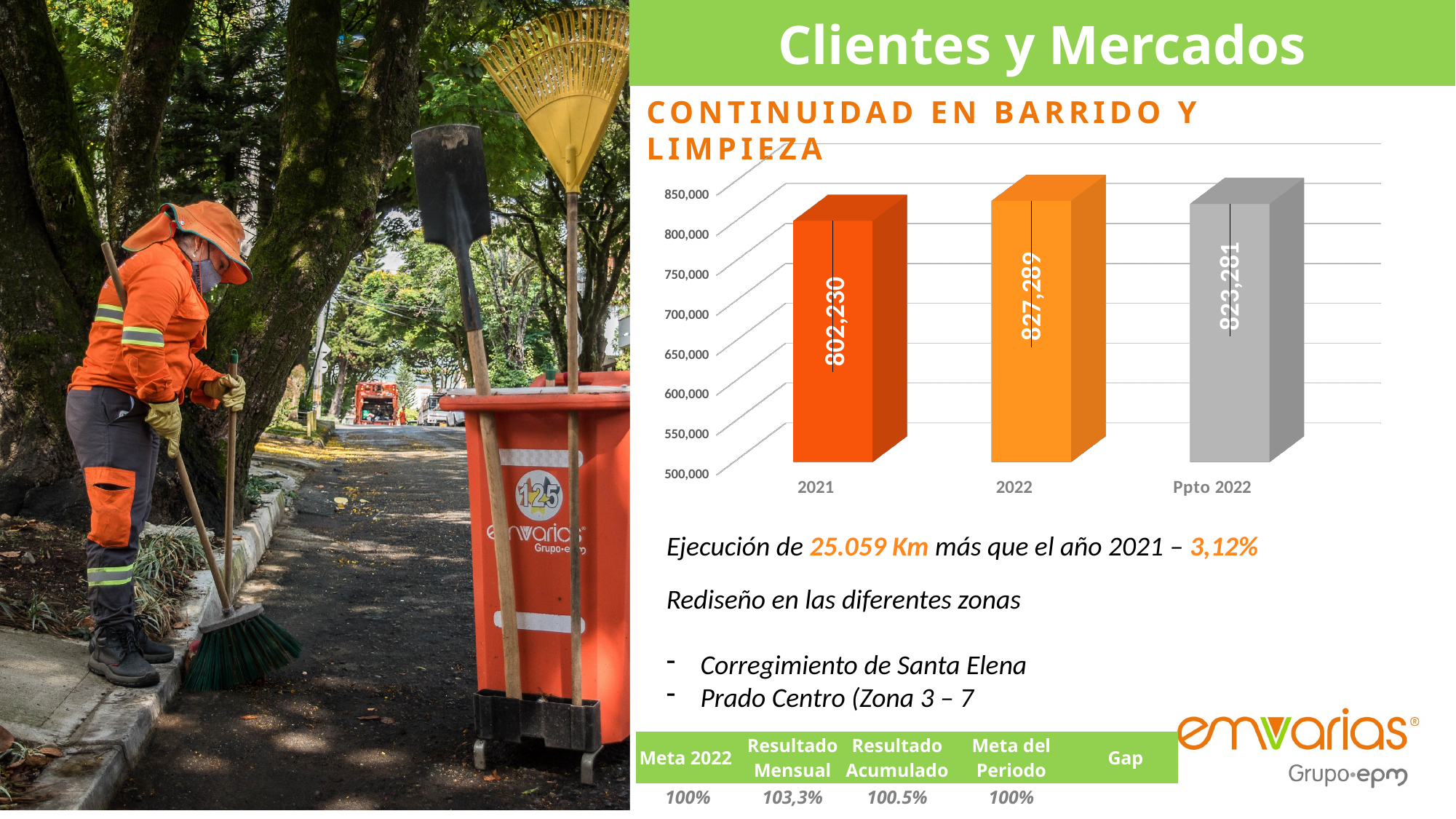
Which category has the highest value in the chart? 2022 What is the value shown for 2021 in the chart? 802,230 What is the difference between the 2022 value and the 2021 value? 25,059 Is the value for 2022 greater or less than 800,000? greater What is the title of the chart? CONTINUIDAD EN BARRIDO Y LIMPIEZA What is the value shown for 2022 in the chart? 827,289 What is the difference between the 2022 value and the Ppto 2022 value? 4,008 Which category has the lowest value in the chart? 2021 Which is larger, the value for 2022 or the value for Ppto 2022? 2022 What is the value shown for Ppto 2022 in the chart? 823,281 What kind of chart is shown on the slide? bar chart How many categories are shown on the x axis of the chart? 3